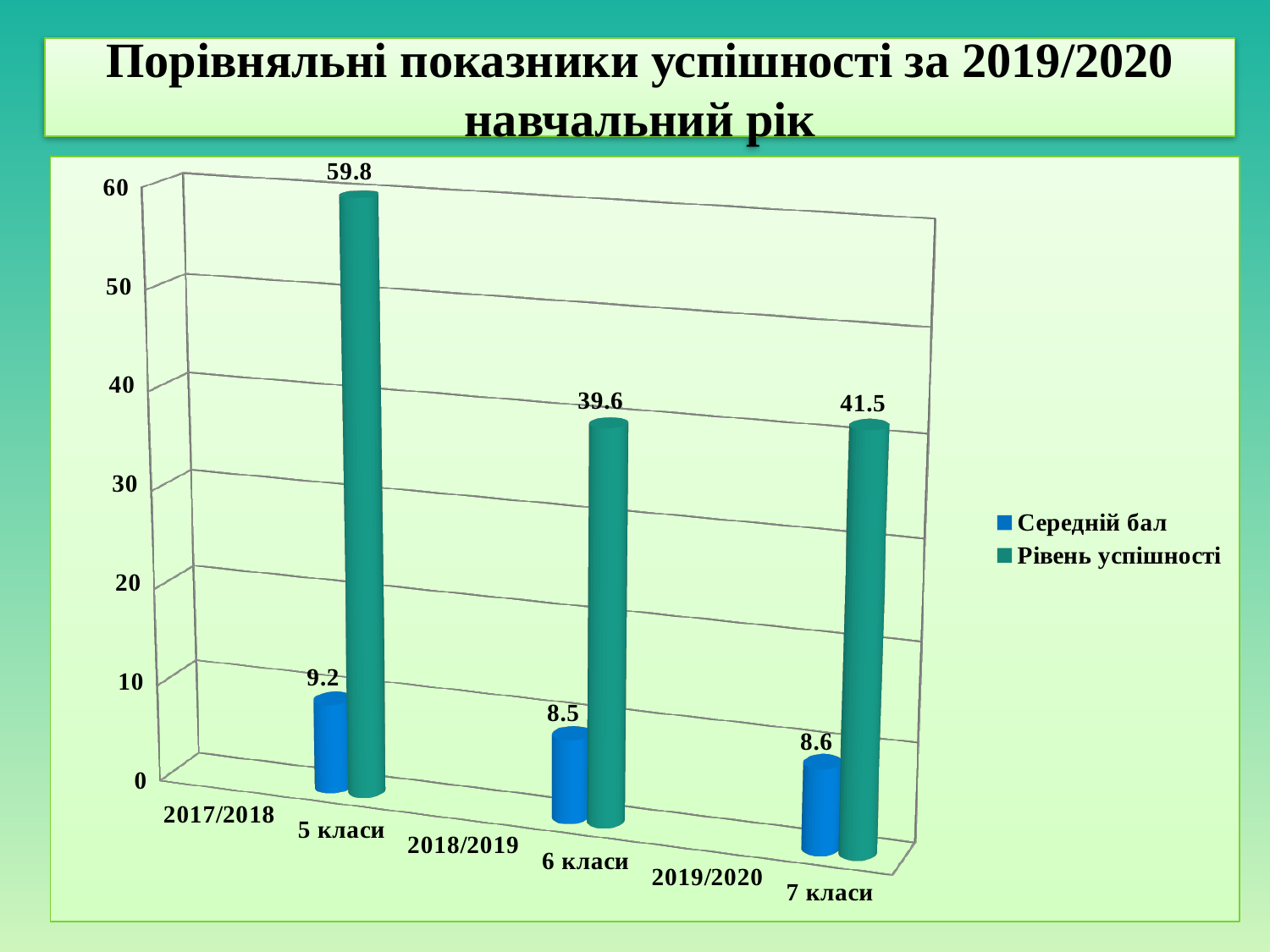
What is the value of Середній бал for 2018/2019 (6 класи)? 8.5 How many categories are shown on the x axis? 6 Which is larger: the Рівень успішності for 2018/2019 or for 2019/2020? 2019/2020 What type of chart is shown on the slide? bar chart What is the value of Середній бал for 2019/2020 (7 класи)? 8.6 What is the difference between the Рівень успішності values for 2017/2018 and 2018/2019? 20.2 Is the Рівень успішності for 2018/2019 greater or less than 50? less Which category has the lowest Середній бал? 2018/2019 (6 класи) What is the value of Рівень успішності for 2019/2020 (7 класи)? 41.5 Which category has the highest Рівень успішності? 2017/2018 (5 класи) How many series does the legend list? 2 What is the value of Рівень успішності for 2017/2018 (5 класи)? 59.8